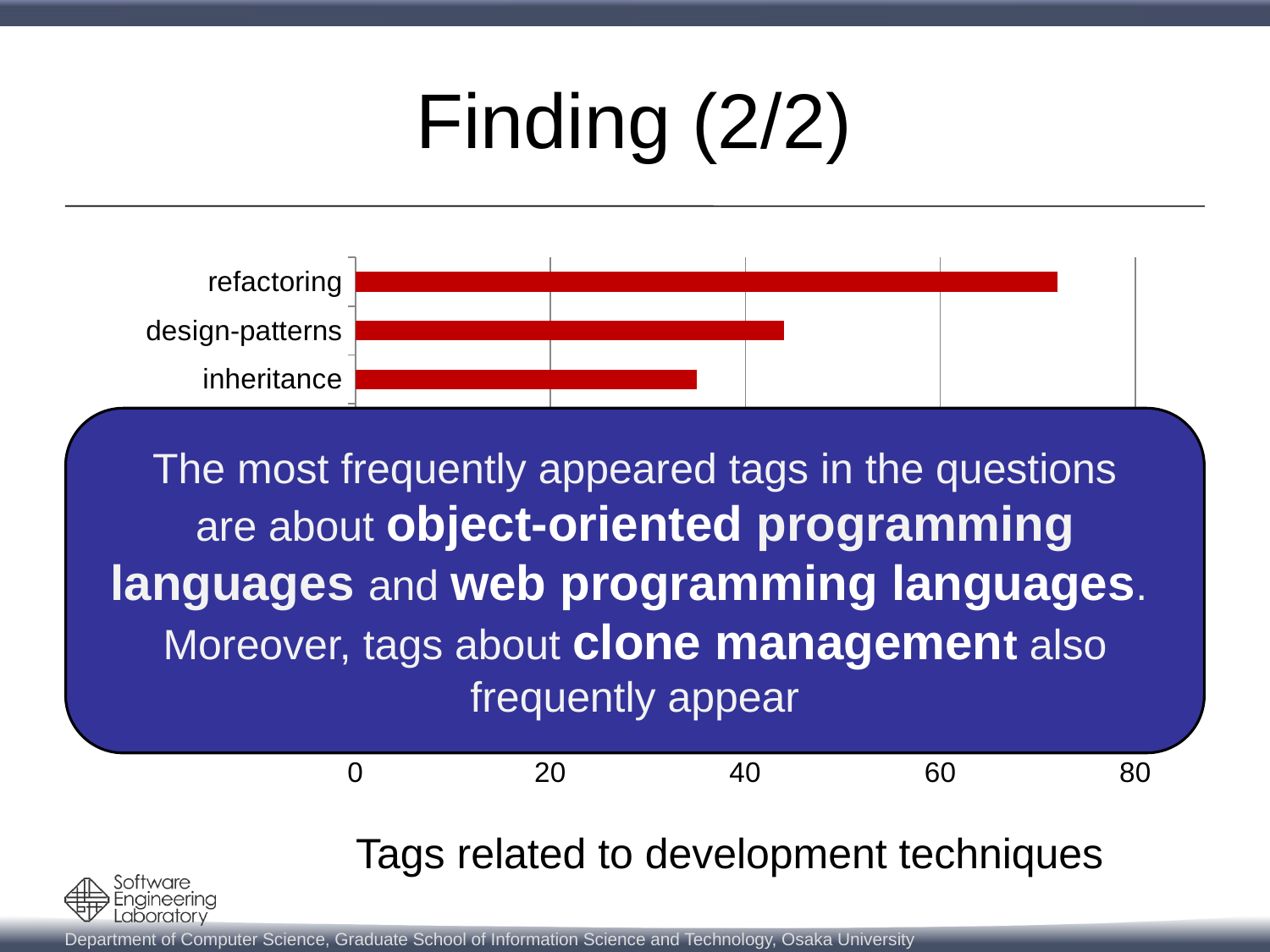
How many category labels are visible on the chart above the blue callout box? 3 What is the caption written below the chart? Tags related to development techniques What colour are the bars in the chart? red What kind of chart is shown on the slide? bar chart Is the value for design-patterns greater or less than 40? greater Which visible category has the longest bar? refactoring Which has a larger value, design-patterns or inheritance? design-patterns Which has a larger value, refactoring or design-patterns? refactoring Which visible category has the shortest bar? inheritance Is the value for refactoring greater or less than 80? less Is the value for inheritance greater or less than 40? less